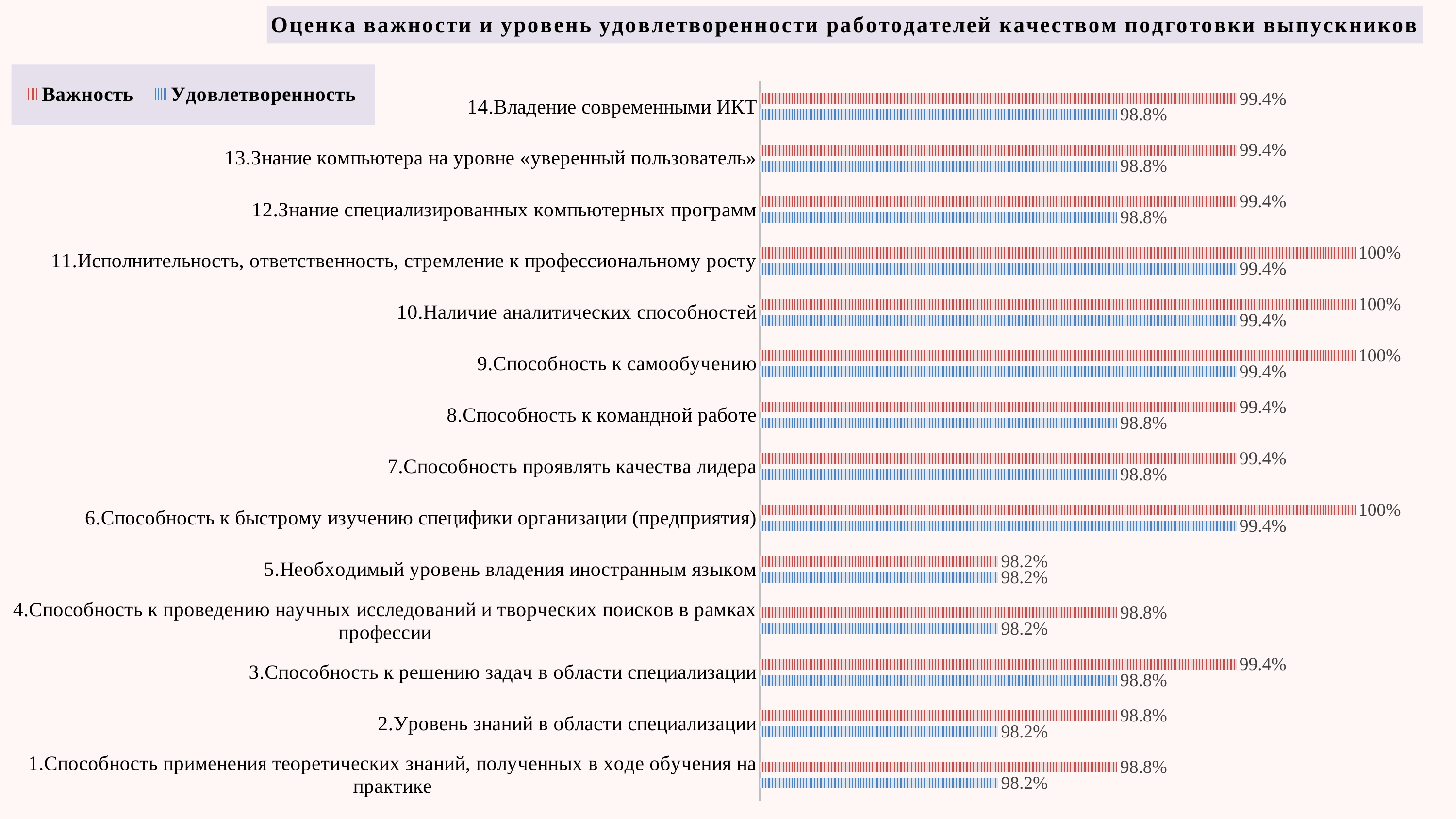
What is the Важность value for "4.Способность к проведению научных исследований и творческих поисков в рамках профессии"? 98.8% Which category has the lowest Важность value? 5.Необходимый уровень владения иностранным языком What kind of chart is shown on the slide? Bar chart What is the difference between the Важность and Удовлетворенность values for "5.Необходимый уровень владения иностранным языком"? 0% What is the Важность value for "9.Способность к самообучению"? 100% What is the difference between the Важность and Удовлетворенность values for "11.Исполнительность, ответственность, стремление к профессиональному росту"? 0.6% How many categories are shown in the chart? 14 For "2.Уровень знаний в области специализации", which is larger: Важность or Удовлетворенность? Важность How many series does the legend list? 2 What is the Удовлетворенность value for "2.Уровень знаний в области специализации"? 98.2% What is the Удовлетворенность value for "14.Владение современными ИКТ"? 98.8% Which series is shown in blue in the legend? Удовлетворенность